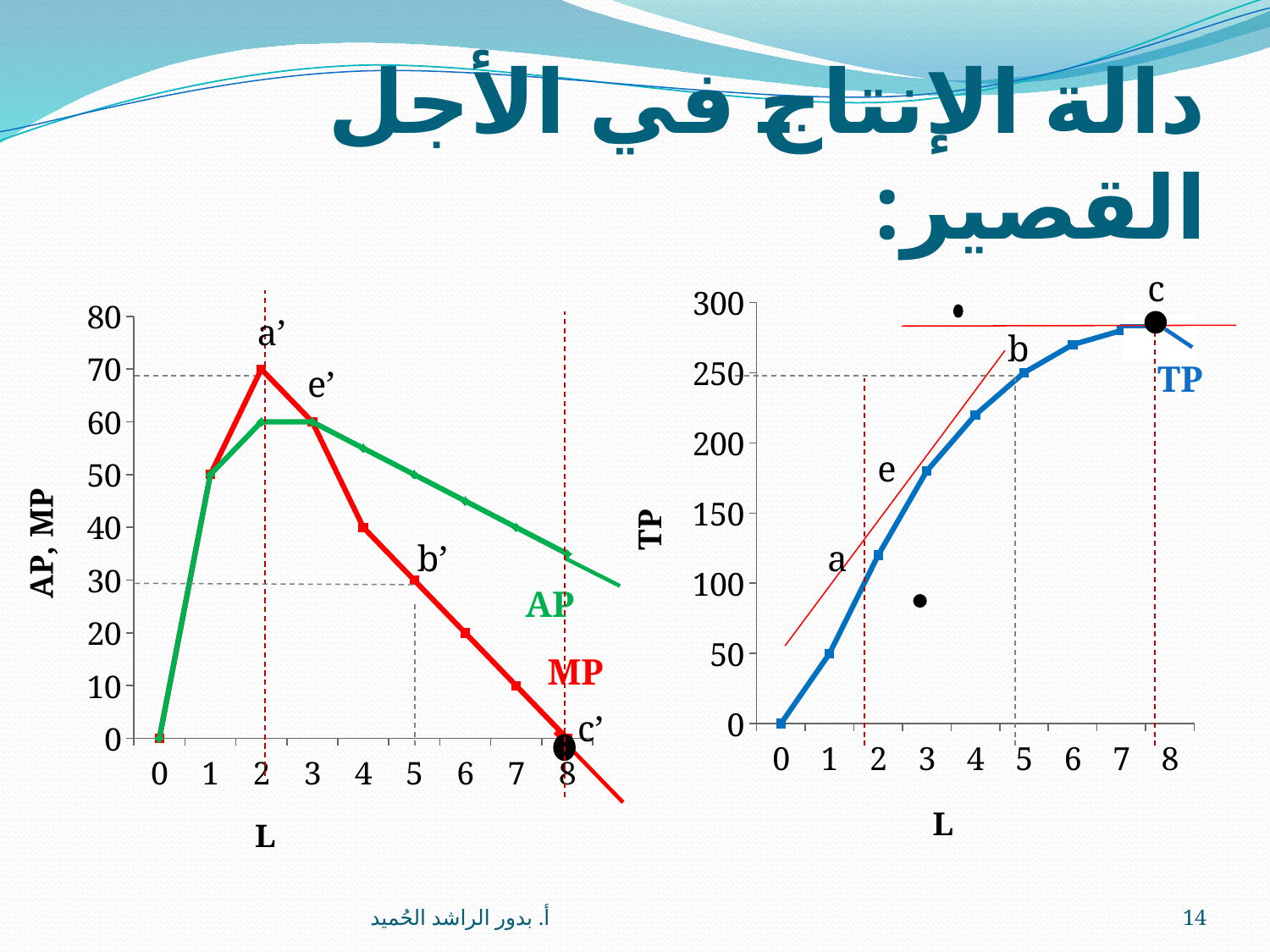
In the right chart (TP), what is the value of TP at L = 1? 50 In the left chart (AP, MP), which series is higher at L = 5, AP or MP? AP In the left chart (AP, MP), what is the value of MP at L = 2? 70 In the left chart (AP, MP), at which value of L does MP reach its maximum? 2 What kind of chart is the left chart (AP, MP against L)? Line chart In the right chart (TP), what is the value of TP at L = 5? 250 How many series are plotted in the left chart (AP, MP)? 2 In the left chart (AP, MP), does MP rise or fall as L increases from 2 to 8? Falls In the right chart (TP), is the value of TP at L = 2 greater or less than 150? less In the left chart (AP, MP), what is the value of MP at L = 5? 30 In the right chart (TP), is the value of TP at L = 3 greater or less than 150? greater In the left chart (AP, MP), what is the value of MP at L = 8? 0